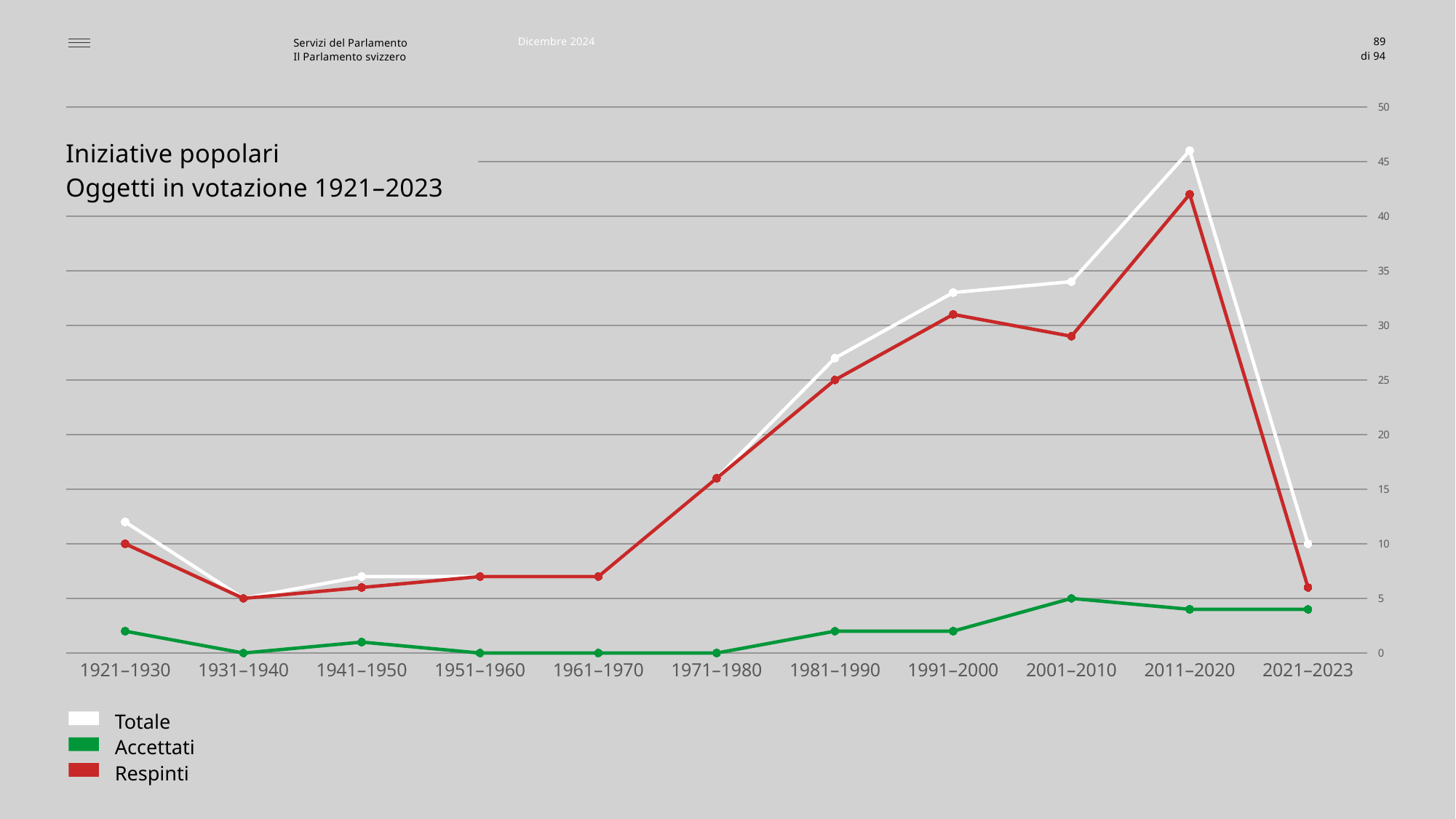
Which period has the highest value for Totale? 2011–2020 What is the value for Accettati in 2001–2010? 5 Which is larger in 1991–2000, Totale or Respinti? Totale What is the value for Totale in 2021–2023? 10 How many series does the legend list? 3 Is the value for Respinti in 2001–2010 greater or less than 30? less Which period has the highest value for Respinti? 2011–2020 What is the value for Respinti in 1921–1930? 10 How many periods are shown on the x axis? 11 Is the value for Totale in 2011–2020 greater or less than 45? greater What kind of chart is shown on the slide? line chart What is the value for Respinti in 1981–1990? 25